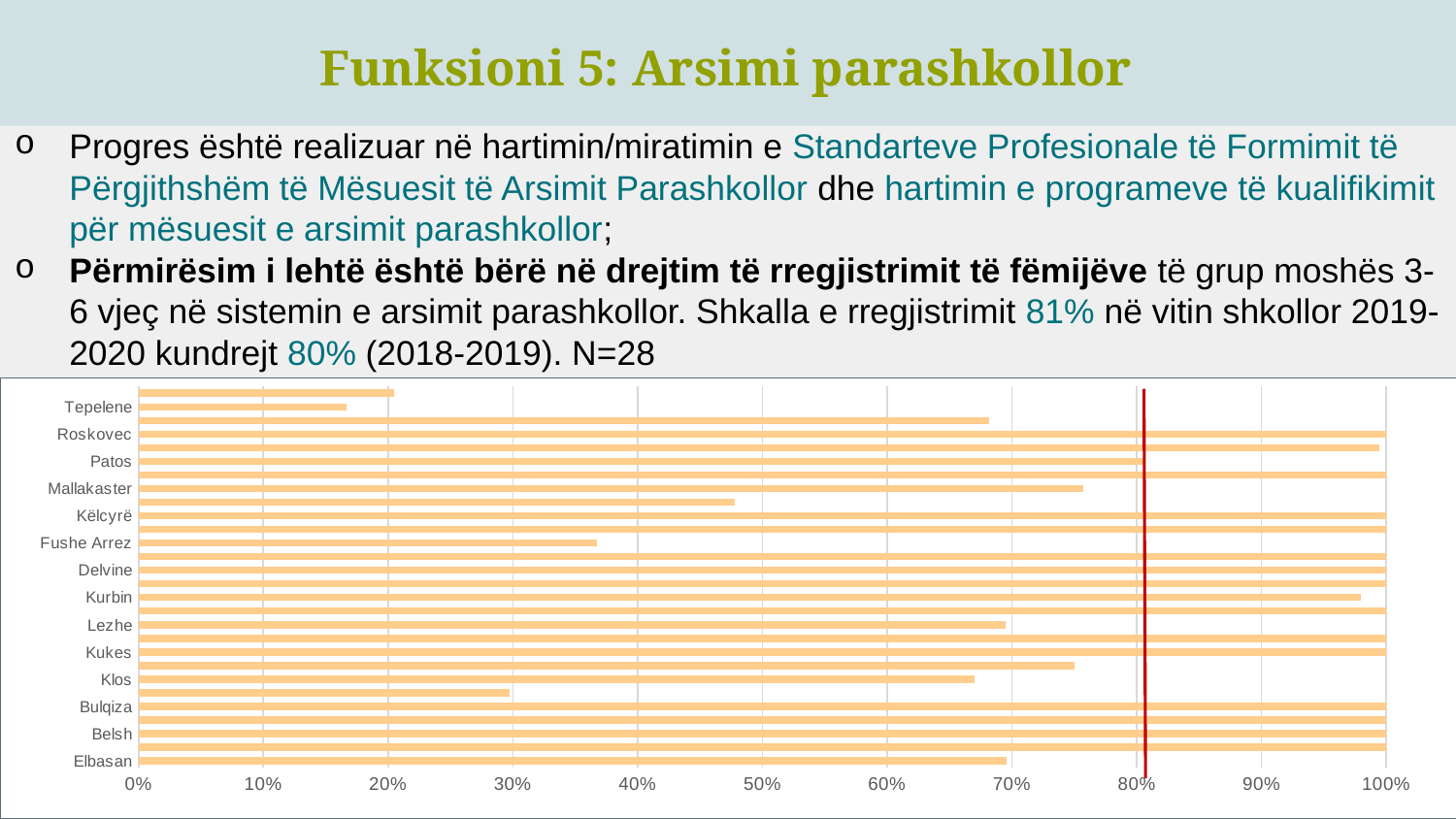
Is the value for Kurbin greater or less than 90%? greater Is the value for Klos greater or less than 80%? less Is the value for Mallakaster greater or less than 70%? greater What is the highest value shown on the horizontal axis of the chart? 100% How many category labels are shown on the vertical axis of the chart? 14 What kind of chart is shown on the slide? bar chart Which labeled category has the lowest value in the chart? Tepelene Which has the larger value, Delvine or Tepelene? Delvine Which has the larger value, Belsh or Klos? Belsh